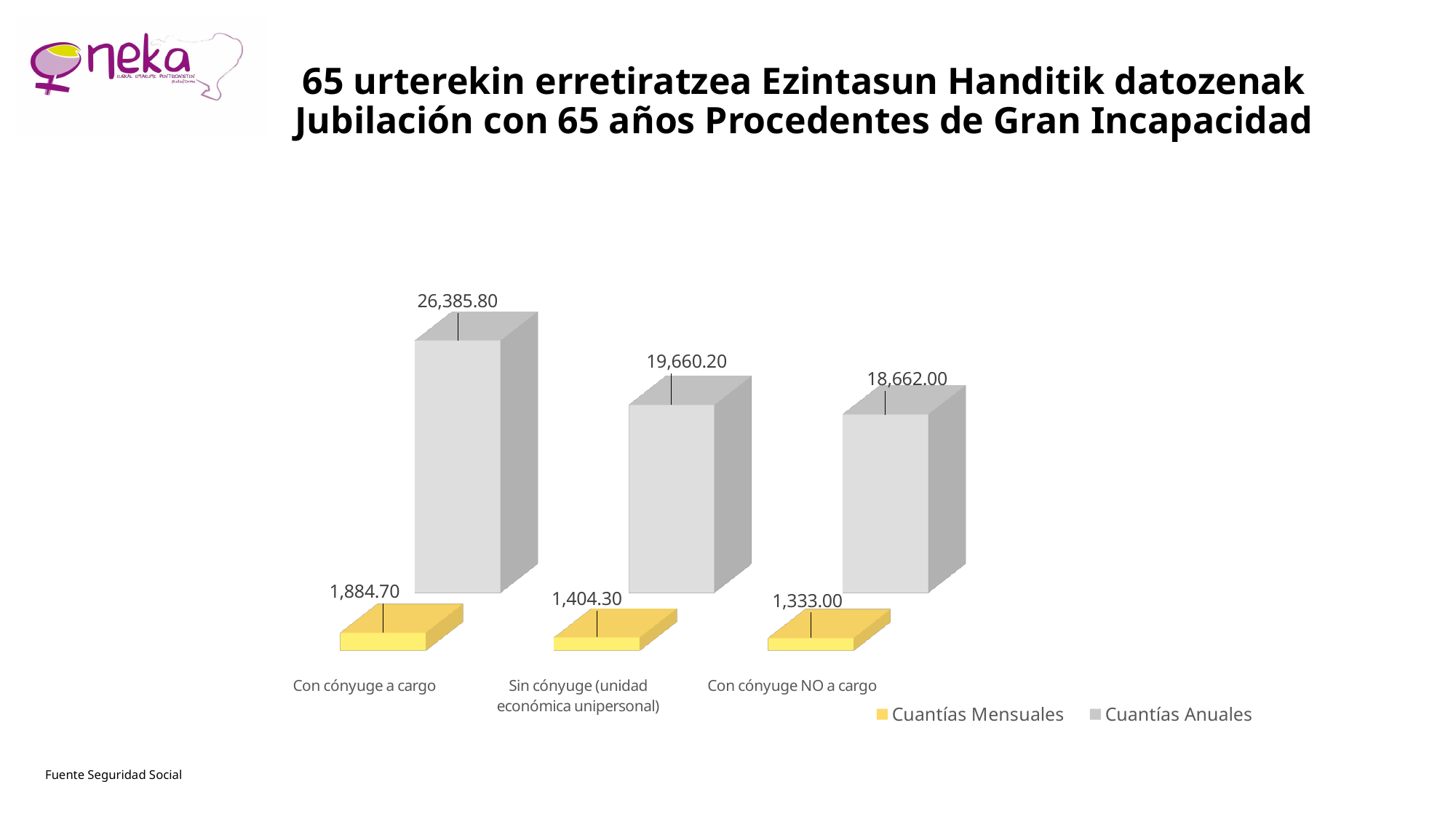
What is the difference between the Cuantías Mensuales values for Con cónyuge a cargo and Con cónyuge NO a cargo? 551.70 What is the Cuantías Anuales value for Con cónyuge a cargo? 26,385.80 What is the Cuantías Anuales value for Con cónyuge NO a cargo? 18,662.00 What is the difference between the Cuantías Anuales values for Con cónyuge a cargo and Sin cónyuge (unidad económica unipersonal)? 6,725.60 What is the Cuantías Mensuales value for Con cónyuge NO a cargo? 1,333.00 How many categories are shown on the x axis of the chart? 3 What kind of chart is shown on the slide? Bar chart What is the Cuantías Mensuales value for Sin cónyuge (unidad económica unipersonal)? 1,404.30 Which category has the highest Cuantías Anuales value? Con cónyuge a cargo Which is larger: the Cuantías Anuales value for Sin cónyuge (unidad económica unipersonal) or for Con cónyuge NO a cargo? Sin cónyuge (unidad económica unipersonal) How many series does the chart legend list? 2 Which category has the lowest Cuantías Mensuales value? Con cónyuge NO a cargo